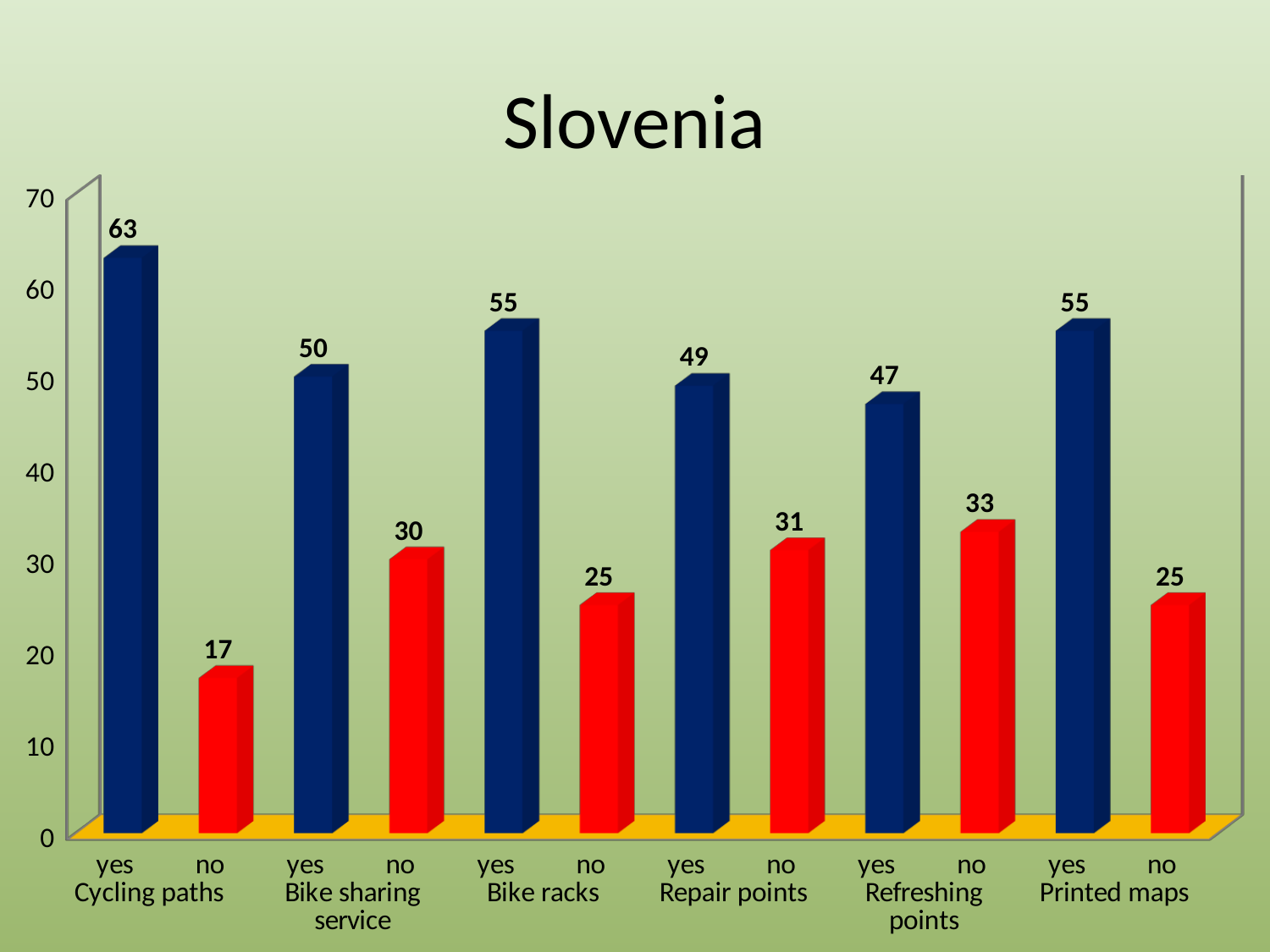
What is the value for 'no' under Refreshing points? 33 Which bar has the lowest value on the chart? no, Cycling paths Which bar has the highest value on the chart? yes, Cycling paths Is the 'yes' value for Refreshing points greater or less than 40? greater What is the value for 'yes' under Cycling paths? 63 Which is larger: the 'no' value for Bike sharing service or the 'no' value for Bike racks? no, Bike sharing service What is the difference between the 'yes' and 'no' values for Repair points? 18 How many bars are plotted on the chart? 12 What colour are the 'no' bars? red What is the title of the chart? Slovenia What is the value for 'no' under Bike sharing service? 30 What kind of chart is shown on the slide? bar chart